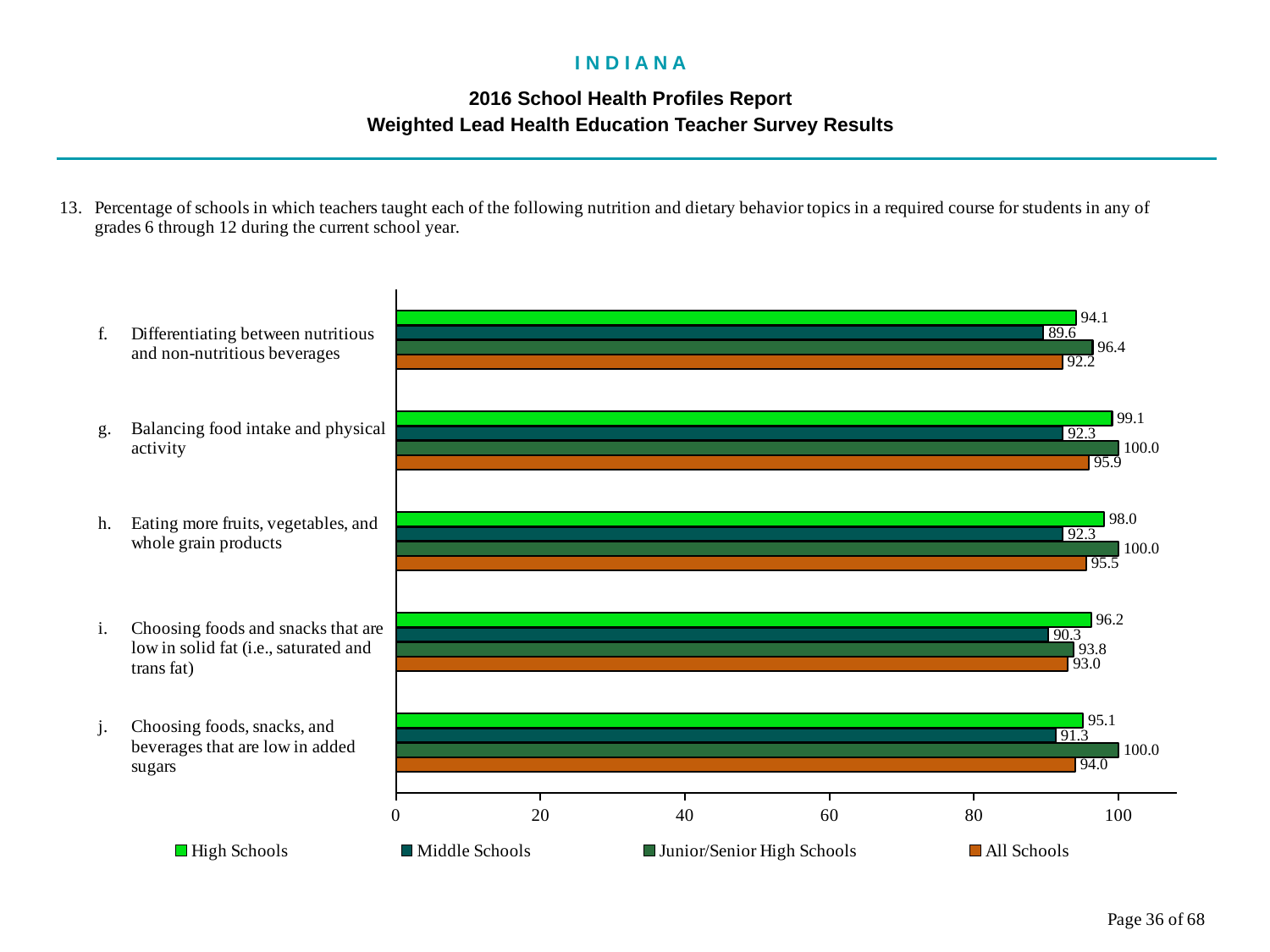
Which category has the highest value for High Schools? Balancing food intake and physical activity How many categories are shown on the chart? 5 Which series is shown in orange in the legend? All Schools For 'Choosing foods and snacks that are low in solid fat', which is larger: the High Schools value or the Junior/Senior High Schools value? High Schools What kind of chart is shown on the slide? bar chart What is the value for High Schools for 'Balancing food intake and physical activity'? 99.1 What is the value for Middle Schools for 'Differentiating between nutritious and non-nutritious beverages'? 89.6 What is the difference between the Junior/Senior High Schools and Middle Schools values for 'Eating more fruits, vegetables, and whole grain products'? 7.7 What is the value for All Schools for 'Choosing foods, snacks, and beverages that are low in added sugars'? 94.0 Which category has the lowest value for Middle Schools? Differentiating between nutritious and non-nutritious beverages Is the value for Middle Schools for 'Choosing foods and snacks that are low in solid fat' greater or less than 80? greater How many series does the legend list? 4